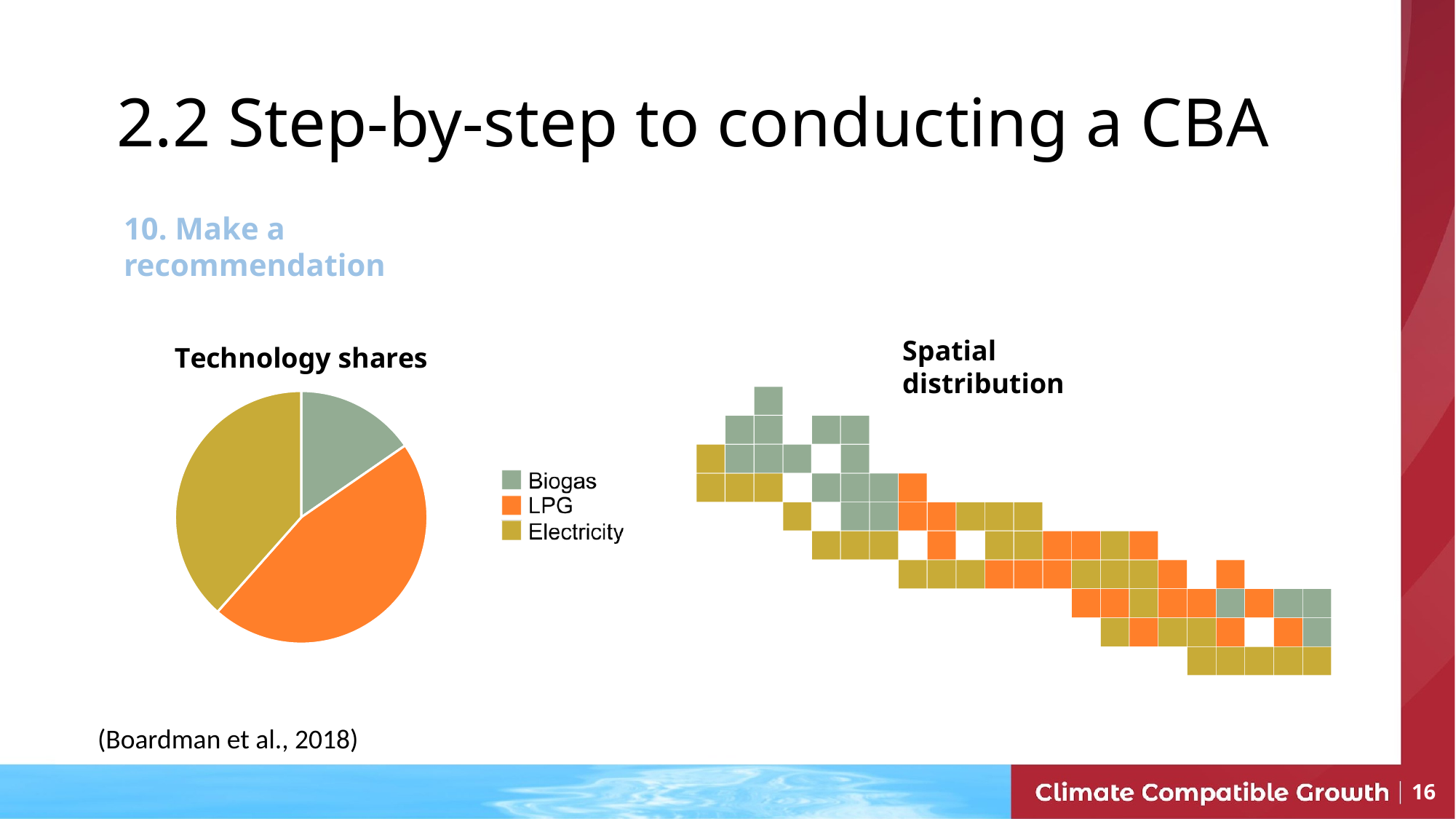
What kind of chart is the Technology shares chart? pie chart In the Technology shares pie chart, which slice is larger, Biogas or Electricity? Electricity How many entries does the legend of the Technology shares chart list? 3 How many slices does the Technology shares pie chart have? 3 In the Technology shares pie chart, which technology has the smallest share? Biogas In the Technology shares chart, which technology is shown in orange? LPG In the Technology shares pie chart, which slice is larger, Biogas or LPG? LPG What is the title of the pie chart on the left of the slide? Technology shares